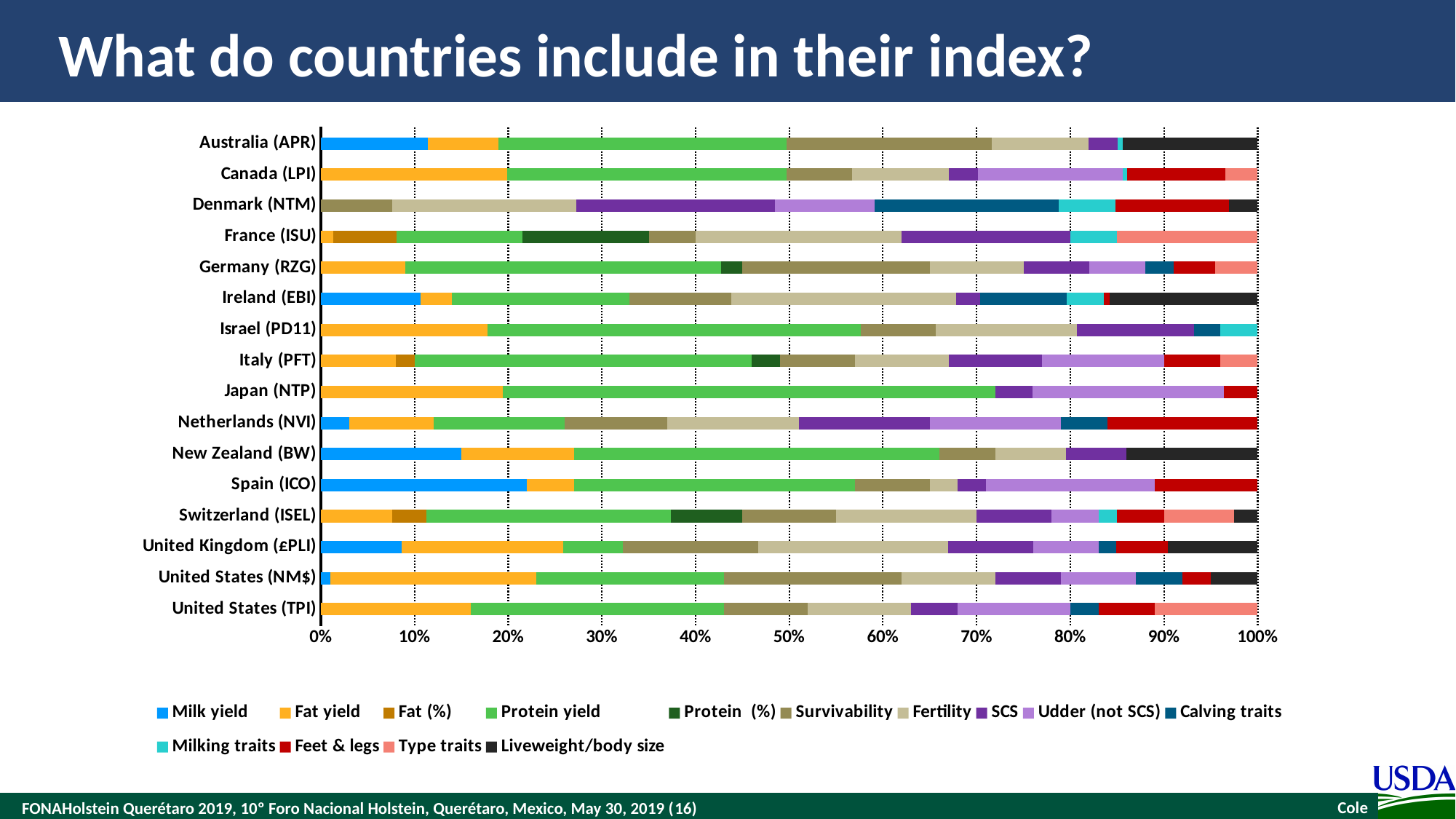
How many countries (categories) are listed on the chart? 16 Which country has a larger Milk yield share, Spain (ICO) or Australia (APR)? Spain (ICO) What kind of chart is shown on the slide? Stacked bar chart Is the Calving traits share for Denmark (NTM) greater or less than 10%? greater What is the title of the slide? What do countries include in their index? Which colour represents Protein yield in the chart? Green How many series does the legend list? 14 Is the Milk yield share for Australia (APR) greater or less than 10%? greater Is the Protein yield share for Japan (NTP) greater or less than 40%? greater Which country has a larger Protein yield share, Japan (NTP) or Netherlands (NVI)? Japan (NTP) Which country has the largest Protein yield share in its index? Japan (NTP)